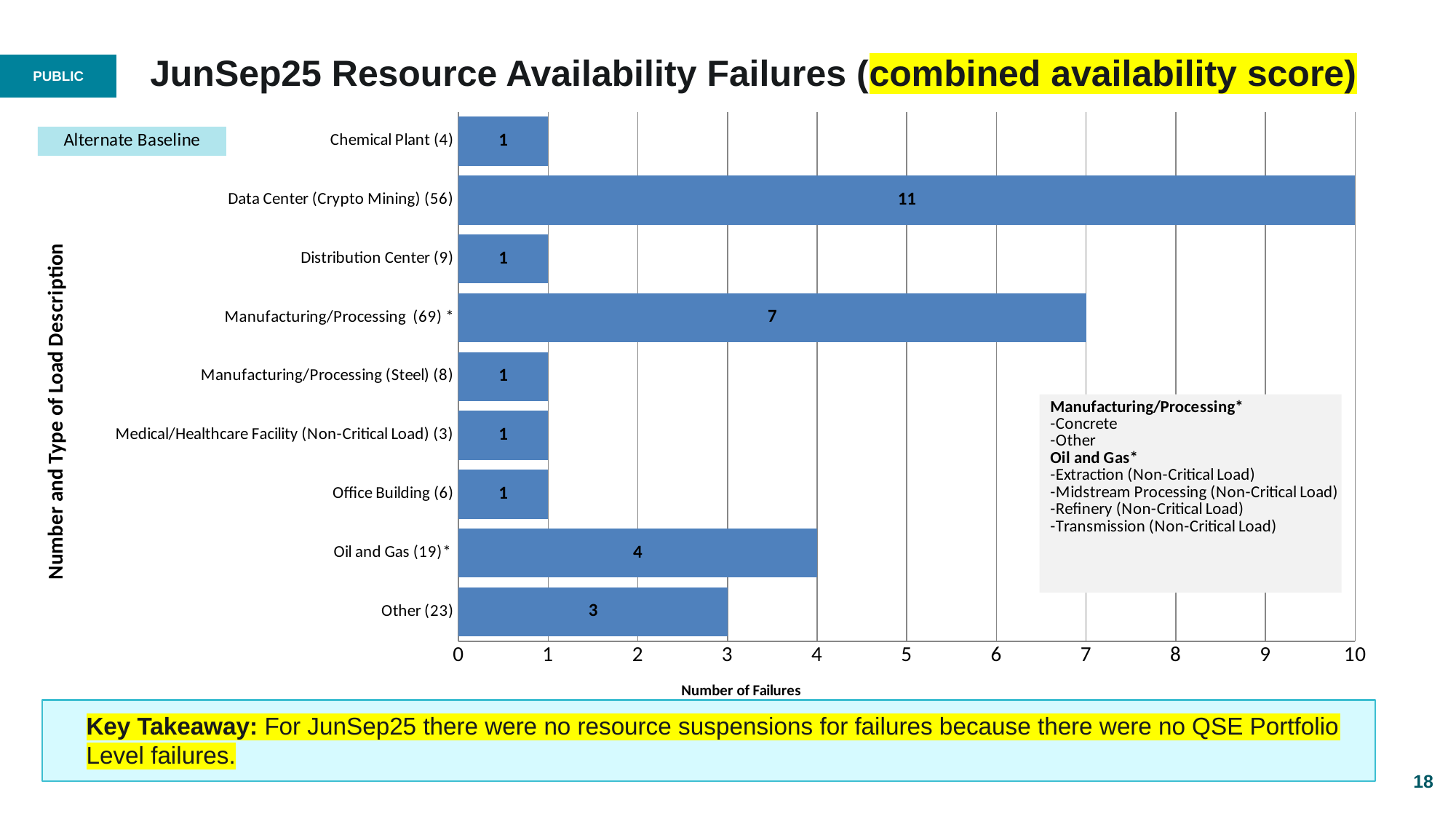
What is the label of the horizontal axis? Number of Failures Which category has the highest number of failures? Data Center (Crypto Mining) (56) What is the number of failures for Data Center (Crypto Mining) (56)? 11 What type of chart is shown on the slide? bar chart What is the number of failures for Other (23)? 3 What is the number of failures for Oil and Gas (19)*? 4 What is the number of failures for Office Building (6)? 1 What is the title of the chart on the slide? JunSep25 Resource Availability Failures (combined availability score) What is the difference in number of failures between Data Center (Crypto Mining) (56) and Manufacturing/Processing (69) *? 4 Which has more failures, Oil and Gas (19)* or Other (23)? Oil and Gas (19)* What is the number of failures for Manufacturing/Processing (69) *? 7 How many load description categories are plotted in the chart? 9